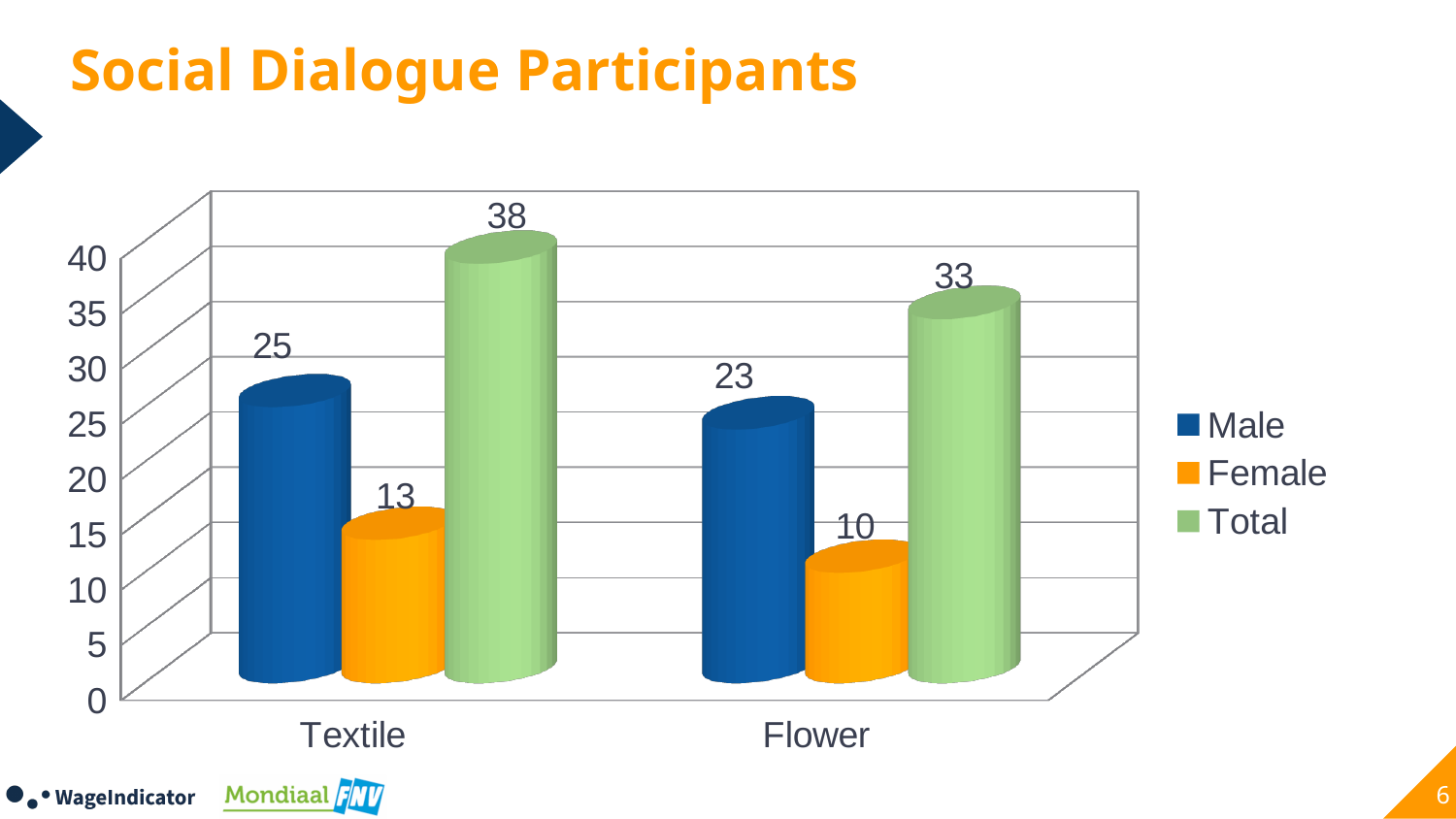
What is the difference between the Male and Female values for Textile? 12 What is the Male value for Textile? 25 Is the Female value for Textile larger or smaller than the Female value for Flower? larger What is the Female value for Flower? 10 What is the Male value for Flower? 23 What is the difference between the Total values for Textile and Flower? 5 Which series has the lowest value for Flower? Female Which category has the higher Total value? Textile What kind of chart is shown on the slide? bar chart What is the Total value for Textile? 38 How many categories are shown on the x axis? 2 How many series does the legend list? 3